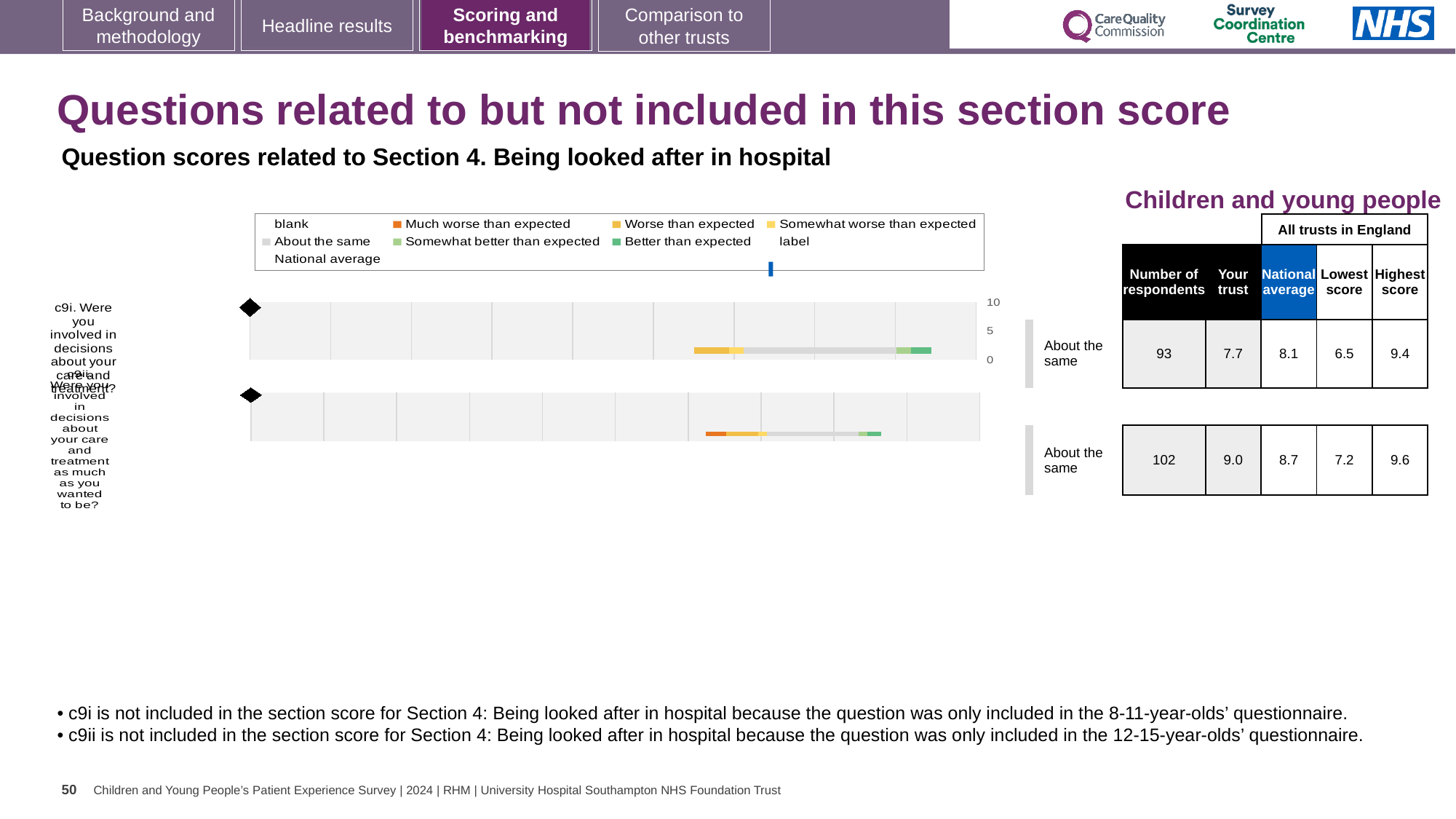
What is the maximum value shown on the chart's axis? 10 According to the table, what is the national average for c9ii? 8.7 What is the highest score across all trusts in England for c9i, as shown in the table? 9.4 According to the table next to the chart, what is the 'Your trust' score for c9i? 7.7 In the chart legend, what colour represents 'Better than expected'? Green What is the difference between the 'Your trust' scores for c9ii and c9i in the table? 1.3 According to the table next to the chart, what is the 'Your trust' score for c9ii? 9.0 What benchmark category is shown beside the bar for c9ii? About the same What kind of chart is used to show the question scores for c9i and c9ii? Bar chart According to the table, how many respondents answered c9i? 93 Which question has the higher 'Your trust' score in the table, c9i or c9ii? c9ii How many questions (c9i and c9ii) are plotted as bars on the slide? 2